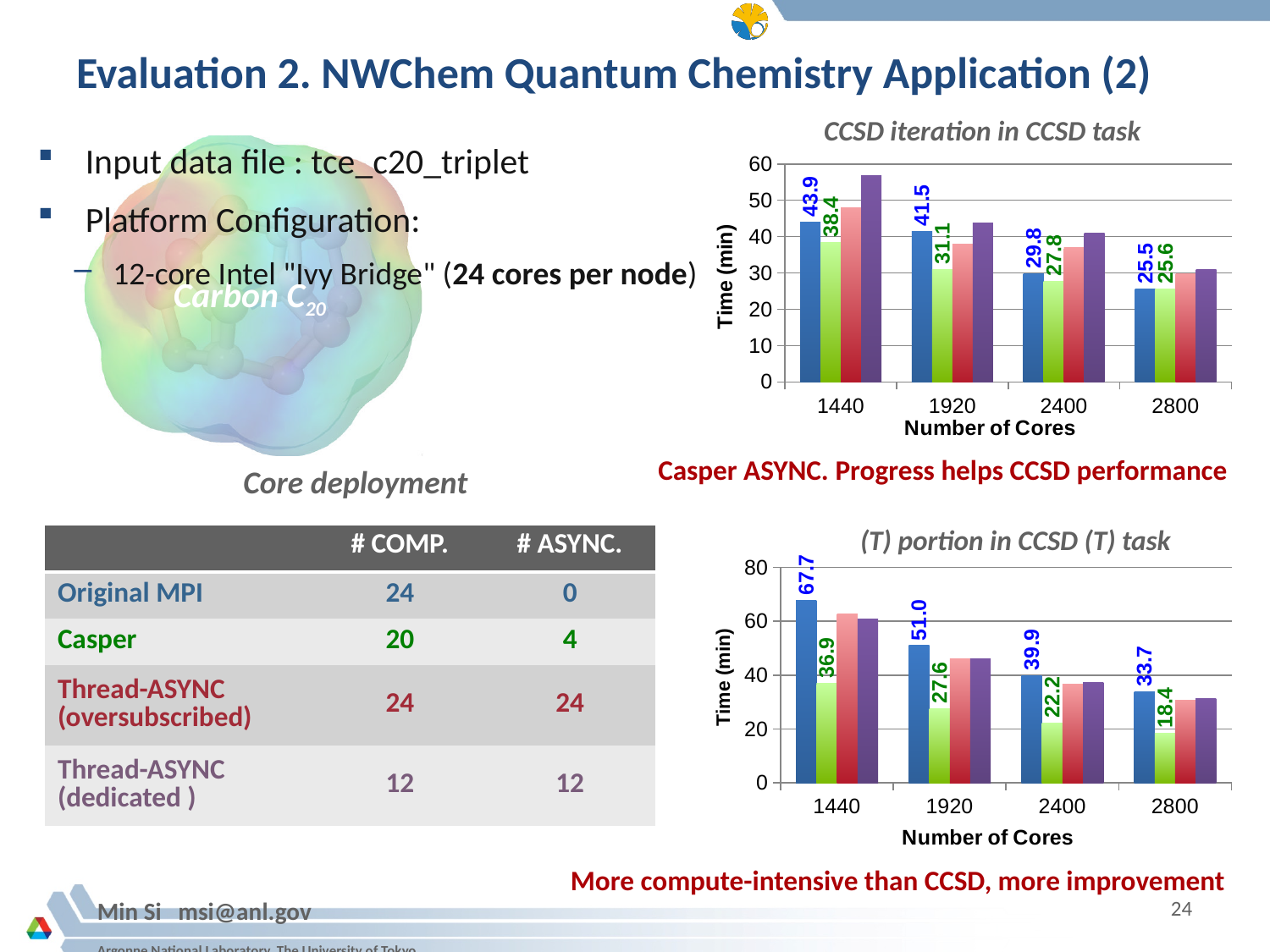
In the 'CCSD iteration in CCSD task' chart, what is the value of the blue bar at 1440 cores? 43.9 In the '(T) portion in CCSD (T) task' chart, do the blue bars rise or fall as the number of cores increases? Fall In the 'CCSD iteration in CCSD task' chart, what is the value of the green bar at 2400 cores? 27.8 In the '(T) portion in CCSD (T) task' chart, what is the value of the green bar at 2800 cores? 18.4 In the '(T) portion in CCSD (T) task' chart, at which number of cores is the blue bar highest? 1440 How many core-count categories are shown on the x axis of the 'CCSD iteration in CCSD task' chart? 4 In the 'CCSD iteration in CCSD task' chart, is the purple bar at 1440 cores greater or less than 50? greater In the '(T) portion in CCSD (T) task' chart, what is the difference between the blue bar and the green bar at 1440 cores? 30.8 In the '(T) portion in CCSD (T) task' chart, what is the value of the blue bar at 1920 cores? 51.0 What is the x-axis title of the 'CCSD iteration in CCSD task' chart? Number of Cores What kind of chart is the '(T) portion in CCSD (T) task' chart? Bar chart In the 'CCSD iteration in CCSD task' chart, what is the difference between the blue bar and the green bar at 1920 cores? 10.4